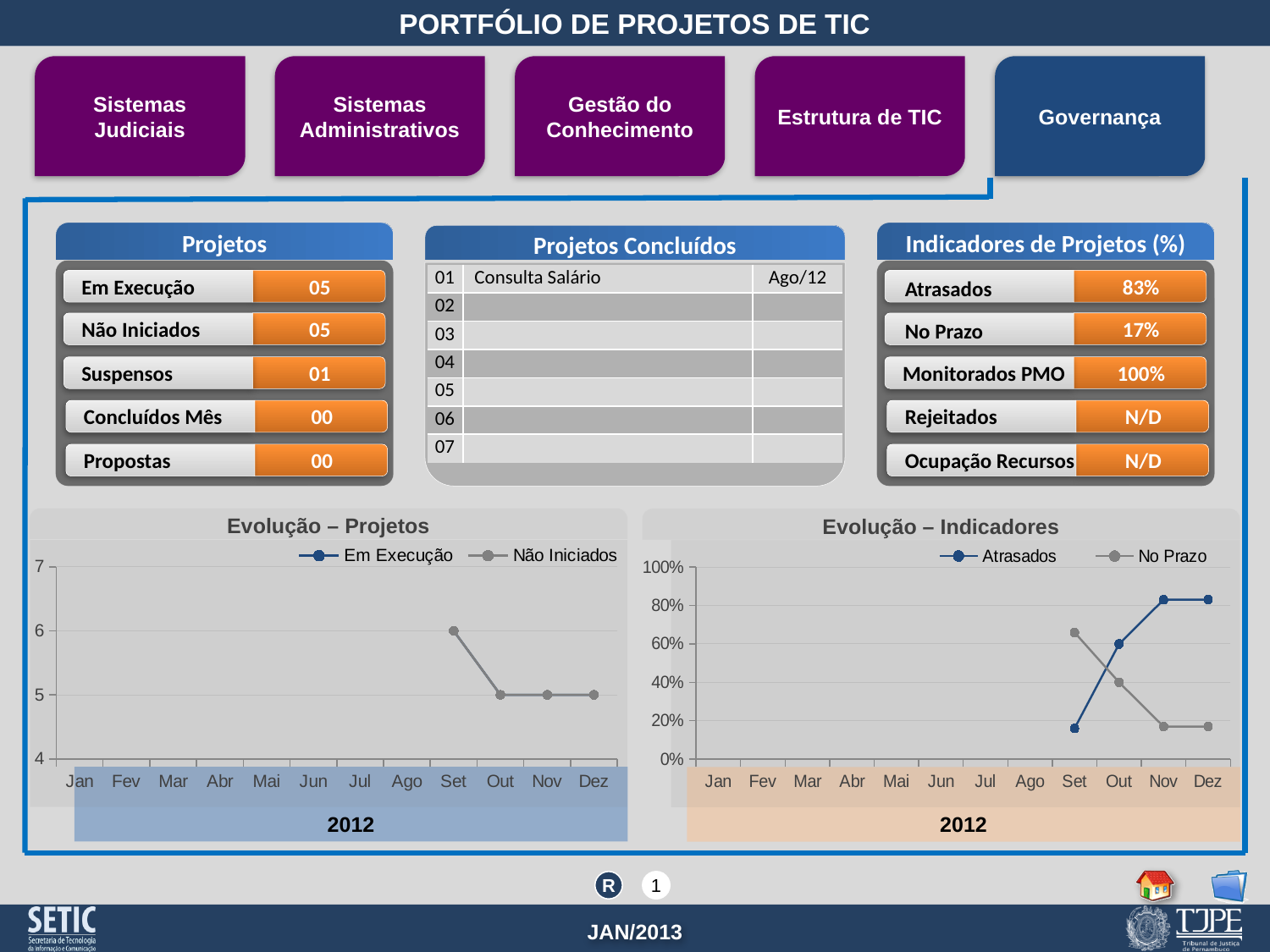
In the 'Evolução – Projetos' chart, what is the value for Não Iniciados in Set? 6 In the 'Evolução – Indicadores' chart, what is the value for Atrasados in Out? 60% In the 'Evolução – Indicadores' chart, is the value for Atrasados in Nov greater or less than 80%? greater In the 'Evolução – Projetos' chart, does the Não Iniciados line rise or fall from Set to Out? fall In the 'Evolução – Indicadores' chart, which series has the higher value in Dez, Atrasados or No Prazo? Atrasados In the 'Evolução – Indicadores' chart, is the value for No Prazo in Set greater or less than 60%? greater In the 'Evolução – Projetos' chart, what is the value for Não Iniciados in Dez? 5 What kind of chart is the 'Evolução – Projetos' chart? line chart How many series does the legend of the 'Evolução – Indicadores' chart list? 2 In the 'Evolução – Indicadores' chart, what is the value for No Prazo in Out? 40% How many months are shown on the x axis of the 'Evolução – Projetos' chart? 12 In the 'Evolução – Indicadores' chart, does the Atrasados line rise or fall from Set to Nov? rise